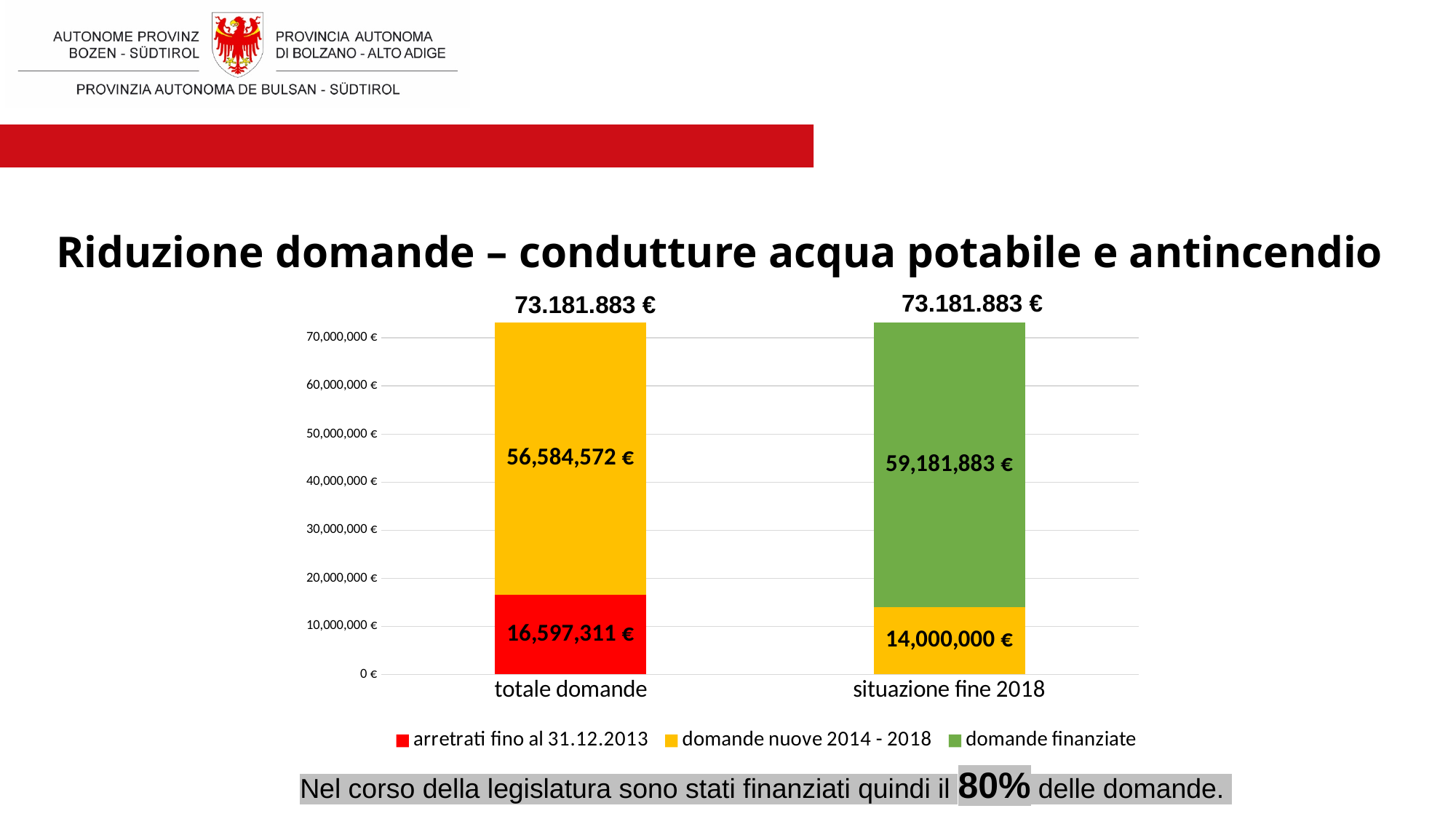
Which is larger: 'domande nuove 2014 - 2018' in 'totale domande' or 'domande finanziate' in 'situazione fine 2018'? domande finanziate in situazione fine 2018 What is the total shown above the 'situazione fine 2018' bar? 73.181.883 € What is the total shown above the 'totale domande' bar? 73.181.883 € What is the difference between 'domande nuove 2014 - 2018' in 'totale domande' and 'domande nuove 2014 - 2018' in 'situazione fine 2018'? 42,584,572 € How many categories are shown on the x axis? 2 What is the value of 'domande finanziate' in the 'situazione fine 2018' bar? 59,181,883 € What type of chart is shown on the slide? stacked bar chart Which colour represents 'domande finanziate' in the chart? green What is the value of 'domande nuove 2014 - 2018' in the 'totale domande' bar? 56,584,572 € What is the value of 'domande nuove 2014 - 2018' in the 'situazione fine 2018' bar? 14,000,000 € How many series does the legend list? 3 What is the value of 'arretrati fino al 31.12.2013' in the 'totale domande' bar? 16,597,311 €